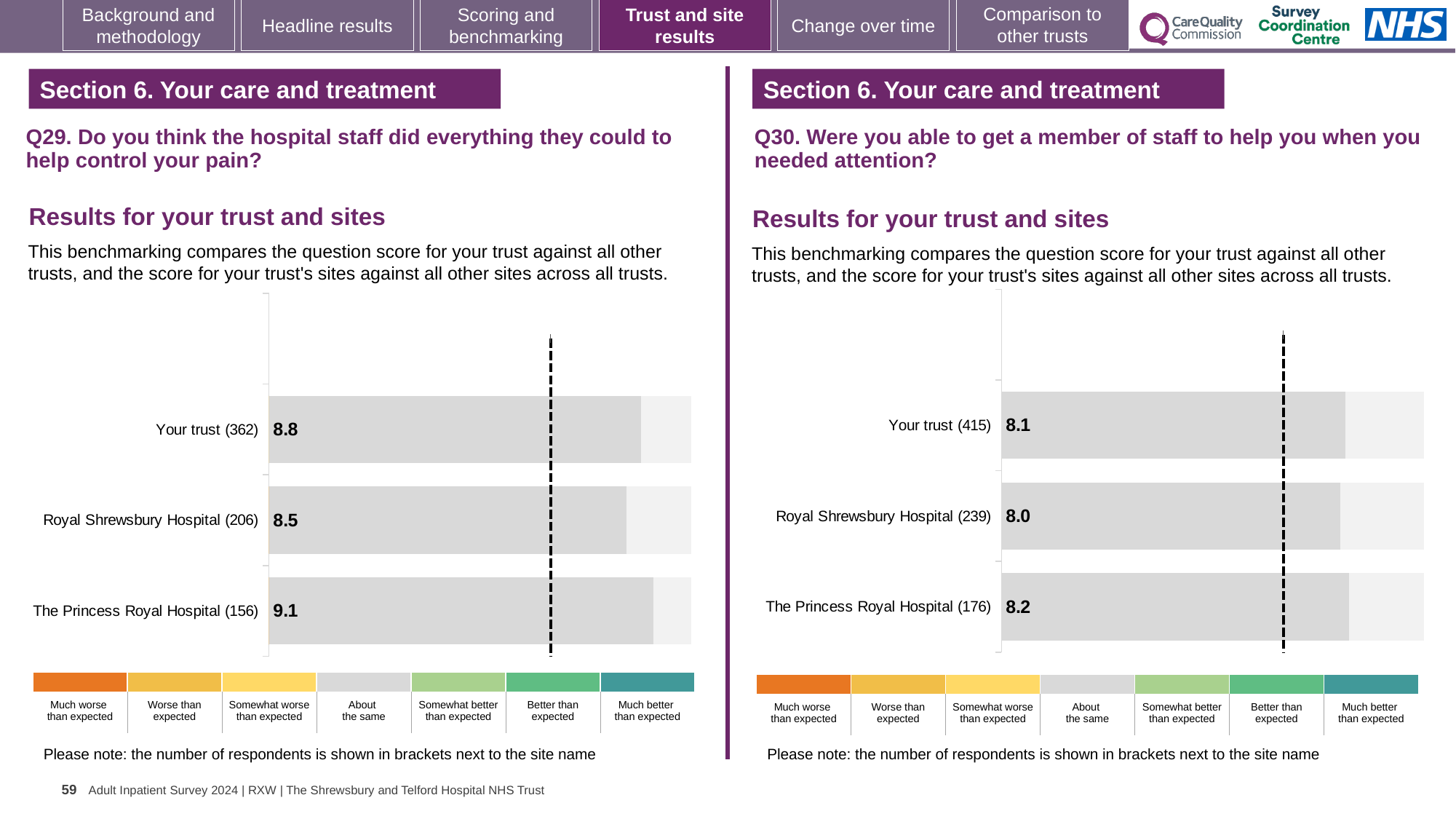
In the Q30 chart on the right, how many respondents are shown in brackets for Your trust? 415 In the Q29 chart on the left, how many bars are plotted? 3 In the Q29 chart on the left, which site or trust has the highest score? The Princess Royal Hospital In the Q30 chart on the right, what is the score for The Princess Royal Hospital? 8.2 In the Q29 chart on the left, what is the difference between the scores for The Princess Royal Hospital and Royal Shrewsbury Hospital? 0.6 In the Q30 chart on the right, what is the score for Your trust? 8.1 In the Q30 chart on the right, is the score for The Princess Royal Hospital larger or smaller than the score for Royal Shrewsbury Hospital? larger What type of chart is used for the Q29 results on the left? bar chart In the Q29 chart on the left, what is the score for Your trust? 8.8 In the Q29 chart on the left, what is the score for Royal Shrewsbury Hospital? 8.5 In the Q30 chart on the right, which site or trust has the lowest score? Royal Shrewsbury Hospital In the Q30 chart on the right, what is the difference between the scores for The Princess Royal Hospital and Royal Shrewsbury Hospital? 0.2